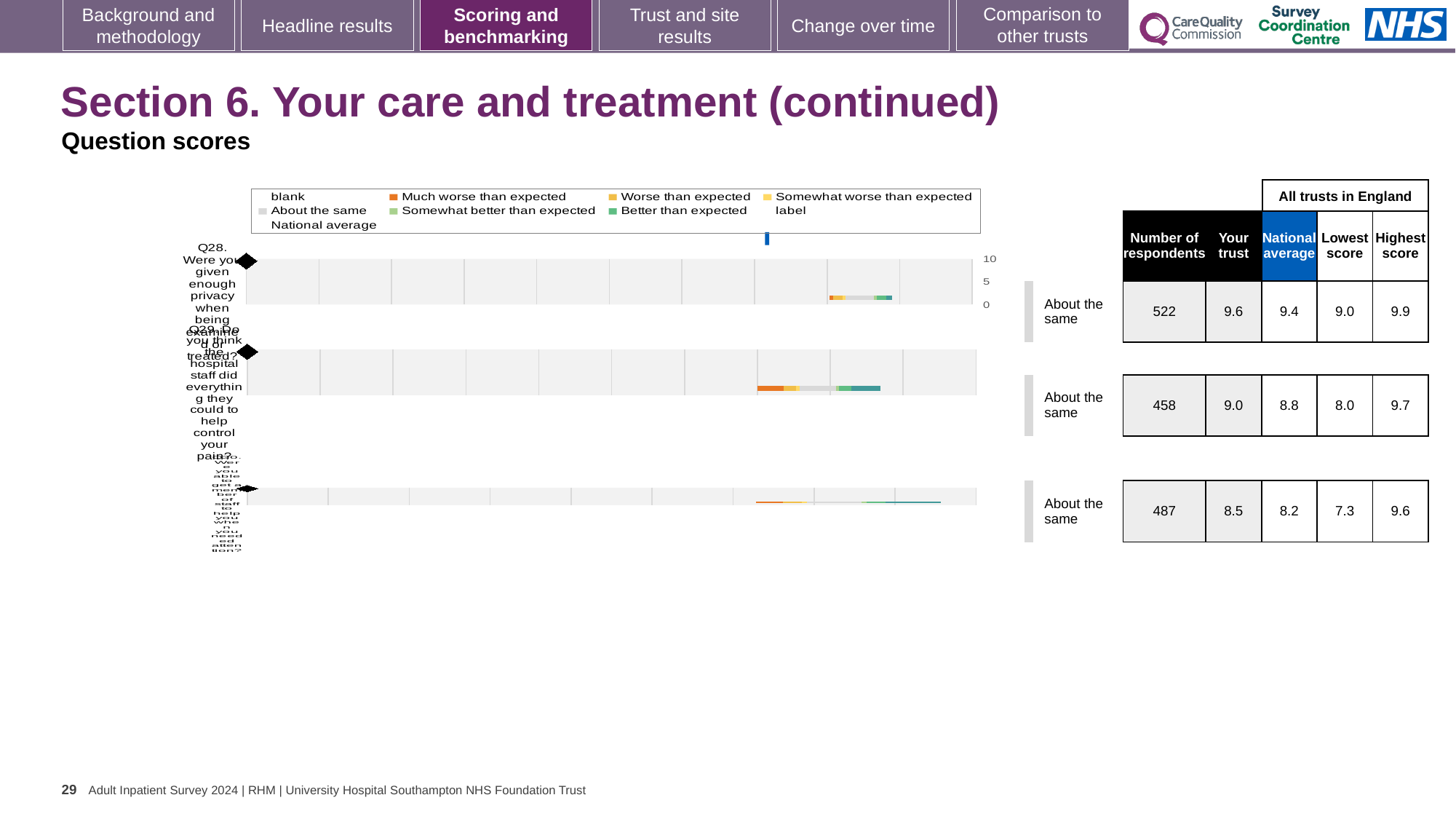
Which question has the lowest 'Lowest score' among all trusts in England? Q30 What is the highest score among all trusts in England for Q28? 9.9 What kind of chart is used to show the question scores? bar chart Which question has the highest 'Your trust' score on this slide? Q28 What is the national average score for Q29 (Do you think the hospital staff did everything they could to help control your pain?)? 8.8 Is the 'Your trust' score for Q30 greater or less than 5 on the chart axis? greater For Q29, which is larger: the 'Your trust' score or the national average? Your trust What is the 'Your trust' score for Q28 (Were you given enough privacy when being examined or treated?)? 9.6 What is the difference between the 'Your trust' score and the national average for Q28? 0.2 How many respondents answered Q30 (Were you able to get a member of staff to help you when you needed attention?)? 487 What benchmark category is shown for Q29? About the same How many questions are charted on this slide? 3